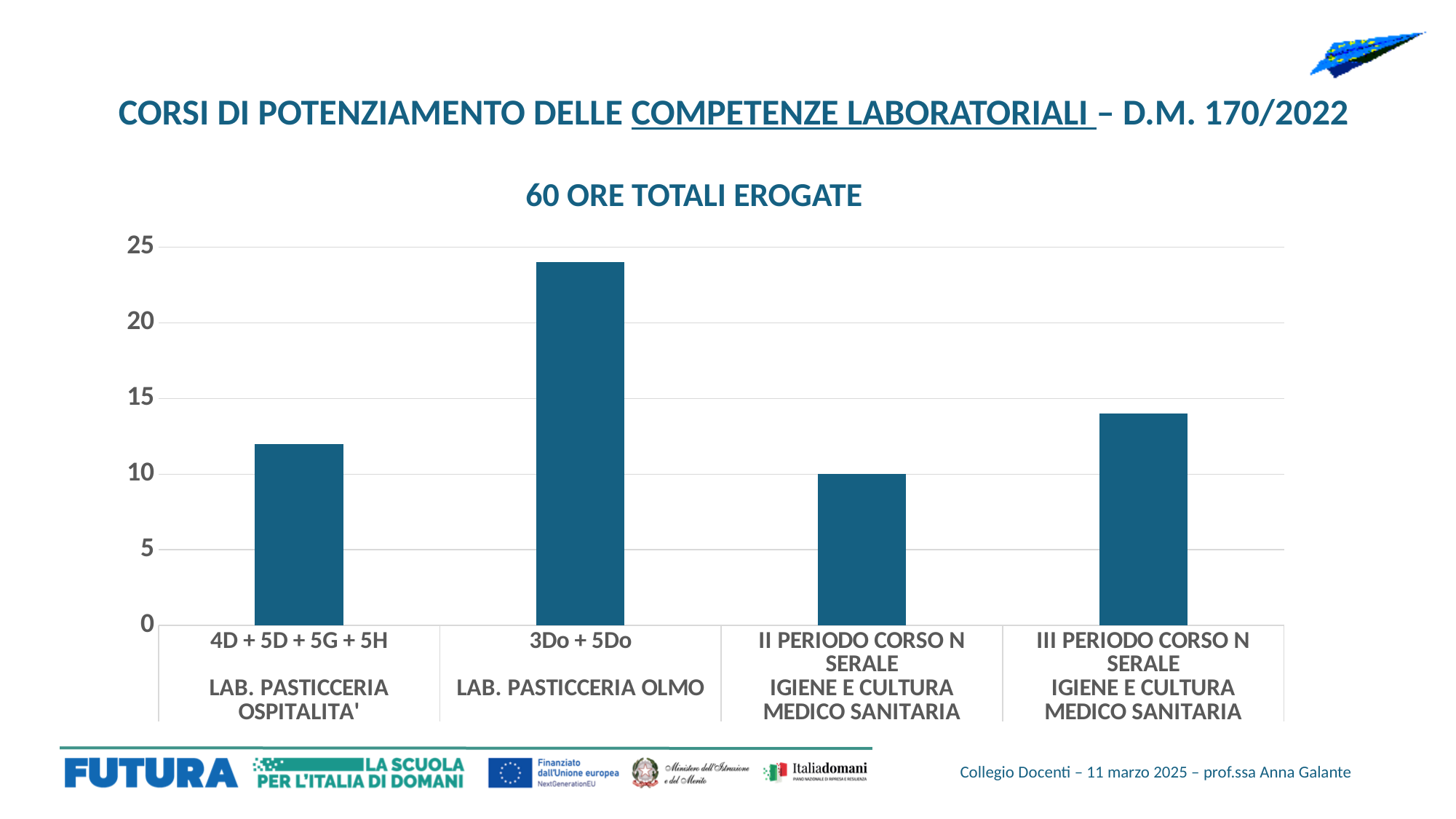
Which category has the highest bar? 3Do + 5Do (LAB. PASTICCERIA OLMO) Is the value for 4D + 5D + 5G + 5H greater or less than 10? greater What is the highest value shown on the vertical axis? 25 What is the title of the chart? 60 ORE TOTALI EROGATE Is the value for 4D + 5D + 5G + 5H greater or less than 15? less How many categories are plotted in the chart? 4 Which is larger, the value for 4D + 5D + 5G + 5H or the value for III PERIODO CORSO N SERALE? III PERIODO CORSO N SERALE What is the value for II PERIODO CORSO N SERALE? 10 Is the value for 3Do + 5Do greater or less than 20? greater Which category has the lowest bar? II PERIODO CORSO N SERALE (IGIENE E CULTURA MEDICO SANITARIA) What kind of chart is shown on the slide? bar chart